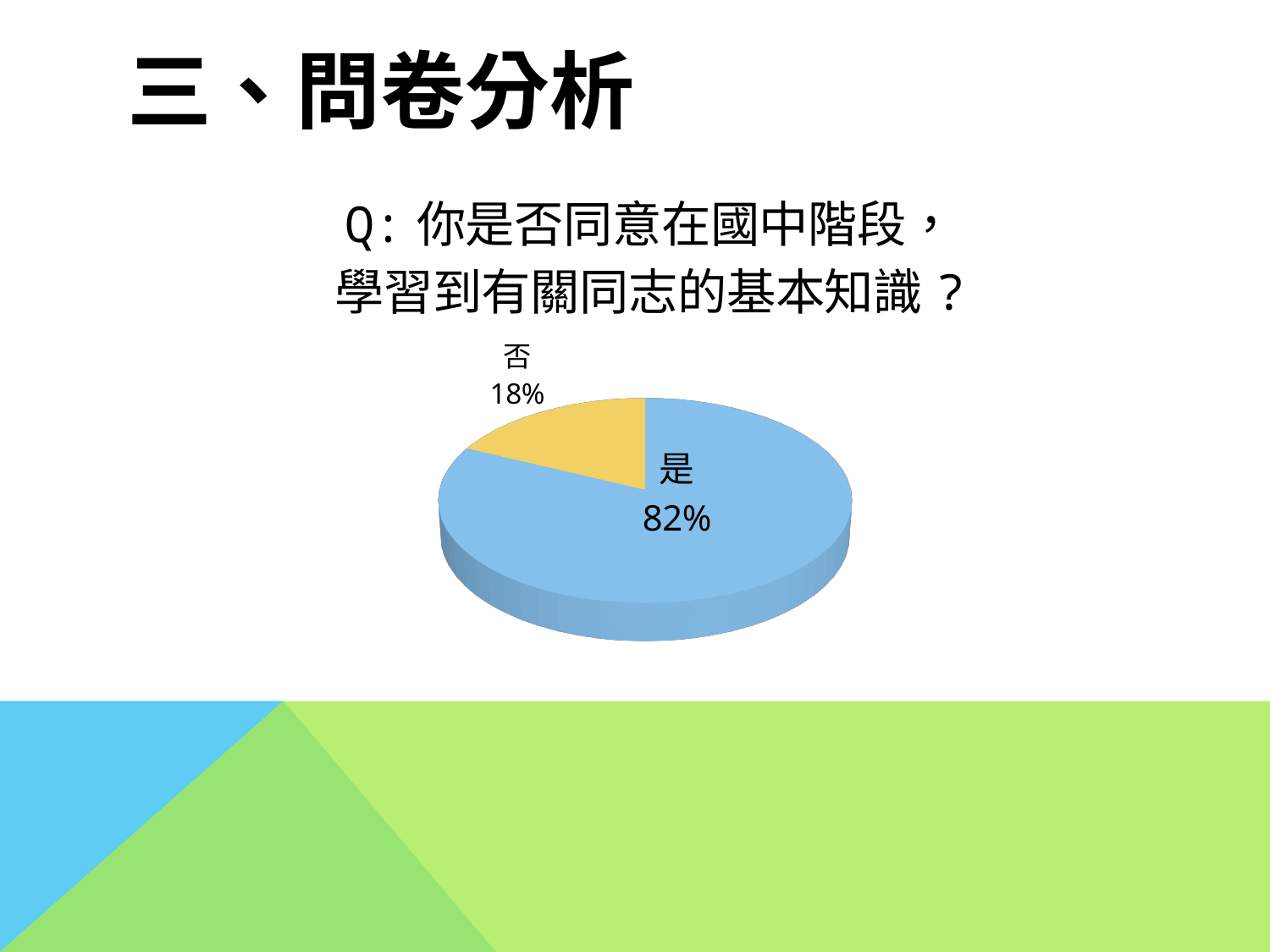
What share of the pie does the 否 slice represent? 18% What kind of chart is shown on the slide? pie chart How many slices does the pie chart have? 2 What is the difference in percentage points between the 是 and 否 slices? 64 What colour is the 是 slice of the pie? blue What colour is the 否 slice of the pie? yellow Which slice of the pie is the largest? 是 Which is larger, the 是 slice or the 否 slice? 是 Is the share for 是 greater or less than 50%? greater What share of the pie does the 是 slice represent? 82% Which slice of the pie is the smallest? 否